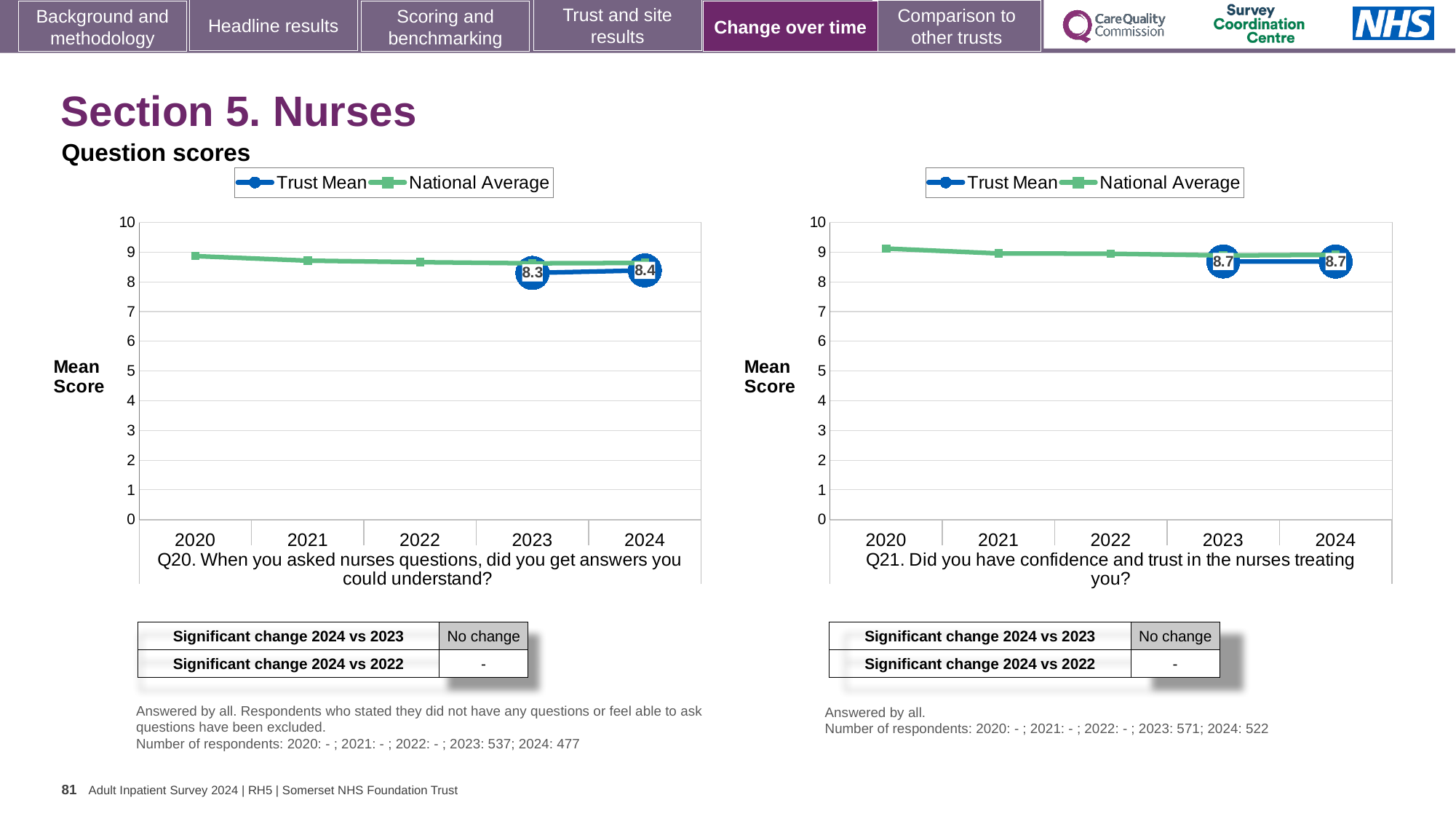
In the Q21 chart on the right, is the National Average for 2020 greater or less than 9? greater In the Q20 chart on the left, did the Trust Mean rise or fall from 2023 to 2024? rise In the Q20 chart on the left, by how much did the Trust Mean change from 2023 to 2024? 0.1 What kind of chart is the Q21 chart on the right? line chart How many years are shown on the x axis of the Q20 chart on the left? 5 In the Q21 chart on the right, what is the Trust Mean score for 2023? 8.7 In the Q20 chart on the left, what is the Trust Mean score for 2023? 8.3 In the Q21 chart on the right, what is the Trust Mean score for 2024? 8.7 How many series does the legend of the Q21 chart on the right list? 2 In the Q20 chart on the left, is the National Average for 2020 greater or less than 8? greater In the Q20 chart on the left, which colour is used for the National Average line? green In the Q20 chart on the left, what is the Trust Mean score for 2024? 8.4